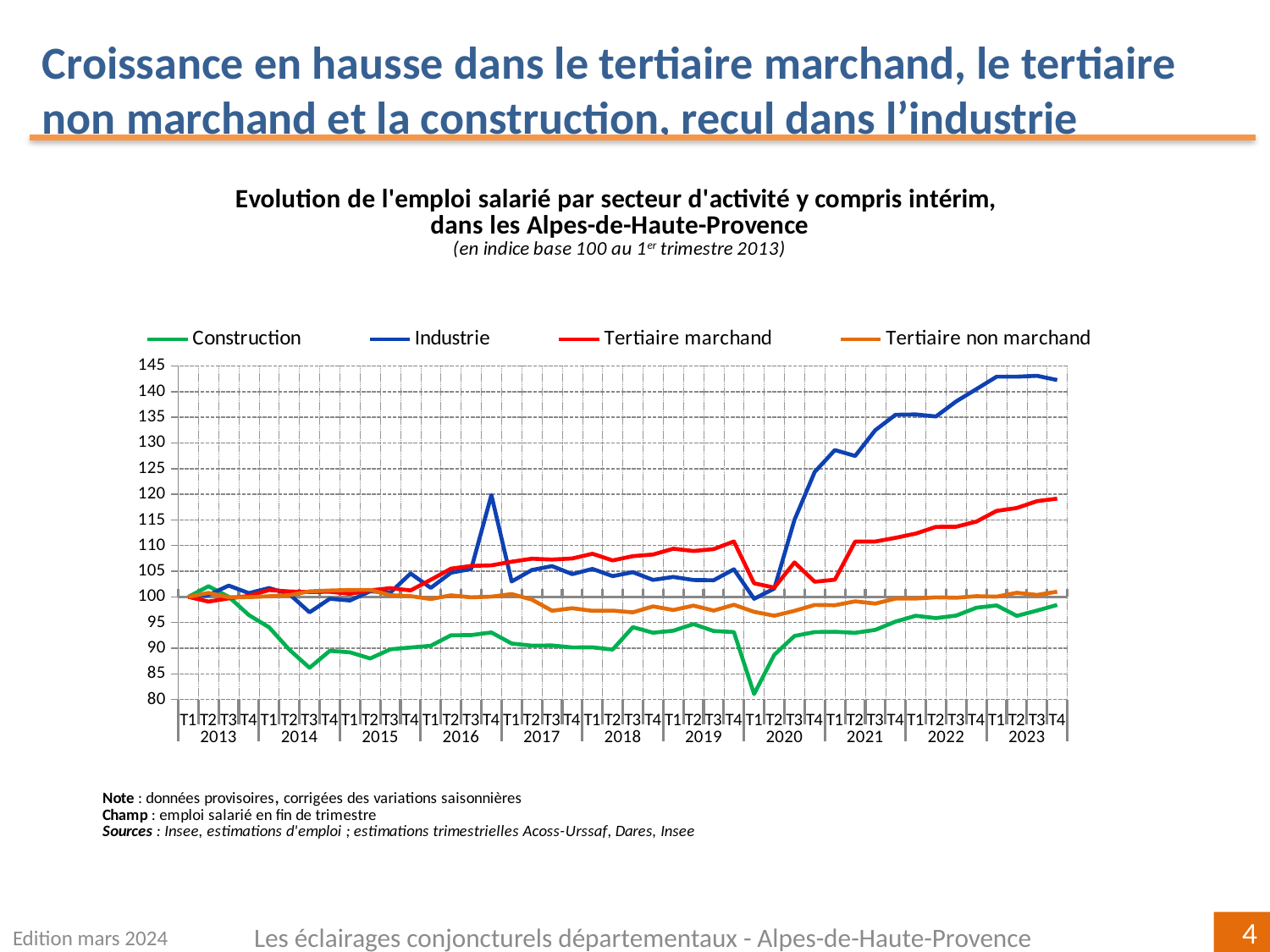
How many series does the legend list? 4 At T3 2014, which is larger: Construction or Tertiaire non marchand? Tertiaire non marchand Which series has the highest value at T4 2023? Industrie Which series has the lowest value at T1 2020? Construction Is the value for Tertiaire marchand at T4 2023 greater or less than 115? greater How many years are labelled along the x axis? 11 Is the value for Construction at T1 2020 greater or less than 85? less Is the value for Industrie at T4 2016 greater or less than 115? greater What kind of chart is shown on the slide? line chart Does the Industrie series rise or fall between T1 2020 and T1 2023? rise Which colour is used for the Construction series? green